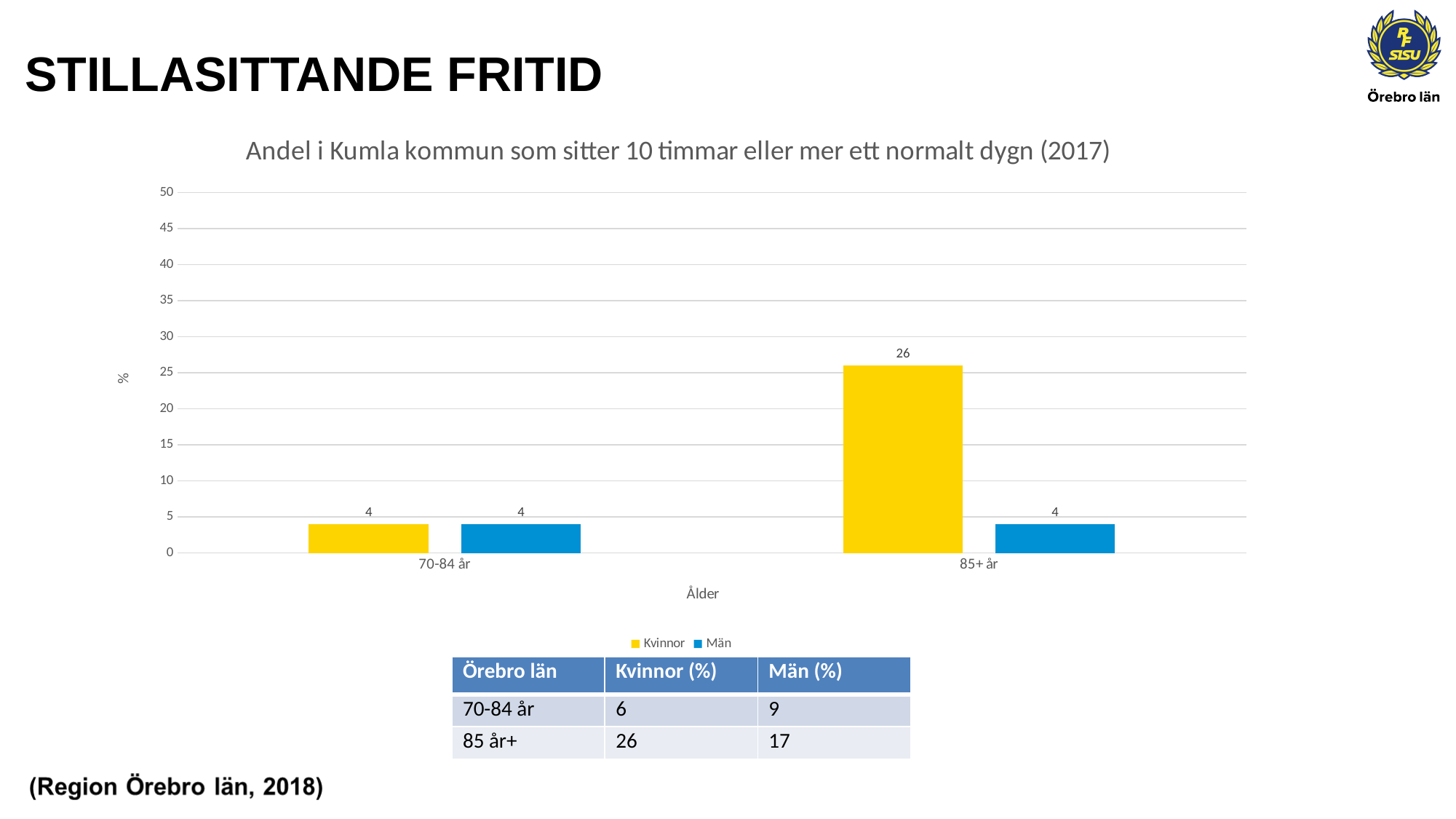
What is the difference between the Kvinnor and Män values in the 85+ år category? 22 Does the Kvinnor value rise or fall from 70-84 år to 85+ år? Rise Is the Kvinnor value for 85+ år greater or less than 20? greater What is the value for Män in the 85+ år category? 4 What is the title of the chart? Andel i Kumla kommun som sitter 10 timmar eller mer ett normalt dygn (2017) How many age categories are shown on the x axis? 2 What is the value for Kvinnor in the 85+ år category? 26 What kind of chart is shown on the slide? Bar chart What is the value for Kvinnor in the 70-84 år category? 4 How many series does the legend list? 2 What is the value for Män in the 70-84 år category? 4 Which series has the highest value in the 85+ år category? Kvinnor